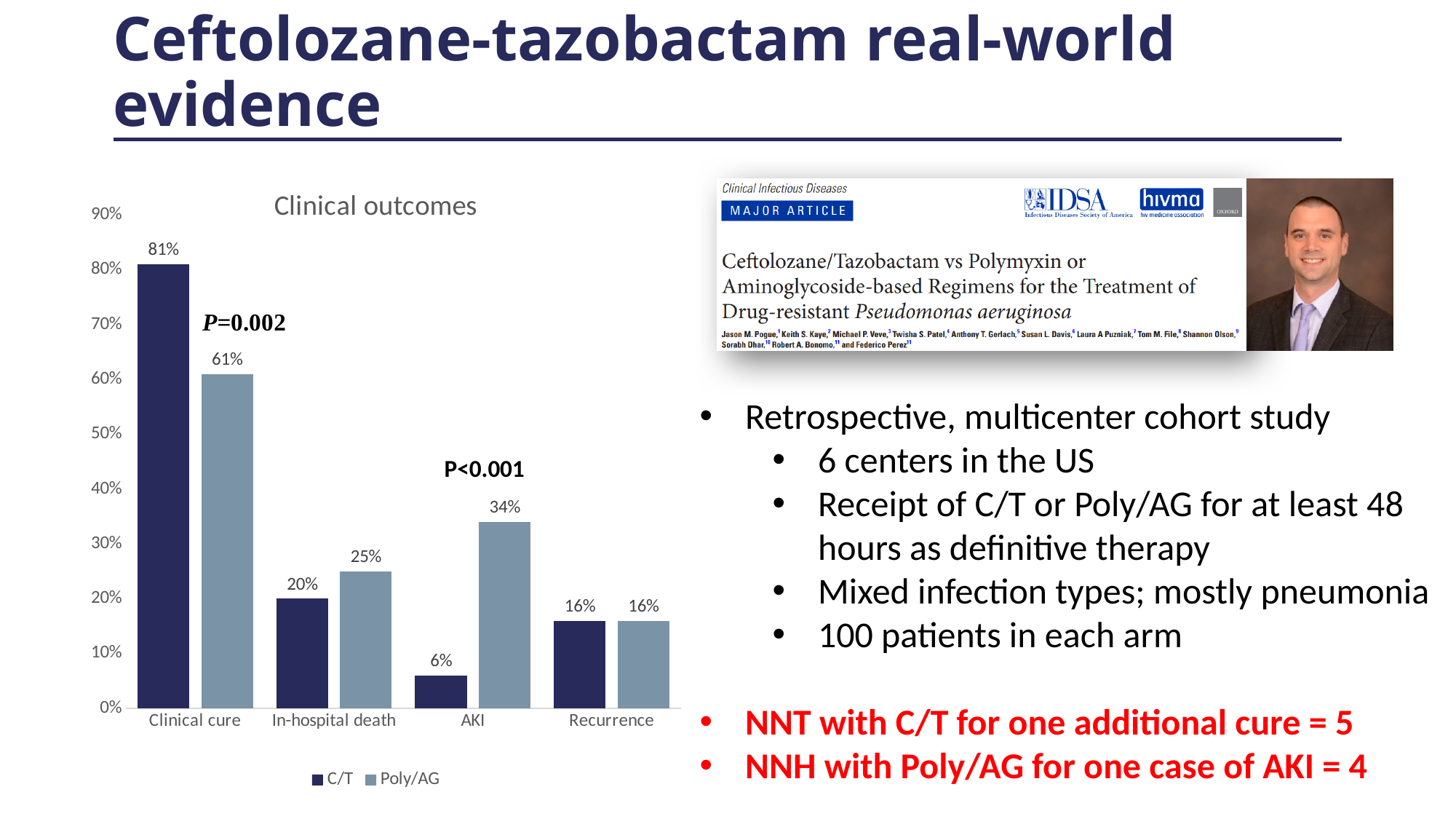
What is the difference between the C/T and Poly/AG clinical cure rates? 20% Which group has the higher in-hospital death rate, C/T or Poly/AG? Poly/AG How many outcome categories are shown on the x axis? 4 How many series does the legend list? 2 What is the recurrence rate for C/T? 16% What type of chart is shown? Bar chart What is the AKI rate for Poly/AG? 34% What is the in-hospital death rate for Poly/AG? 25% Which outcome has the lowest value for C/T? AKI What is the clinical cure rate for C/T? 81% What is the difference between the Poly/AG and C/T AKI rates? 28% Which outcome has the highest value for C/T? Clinical cure